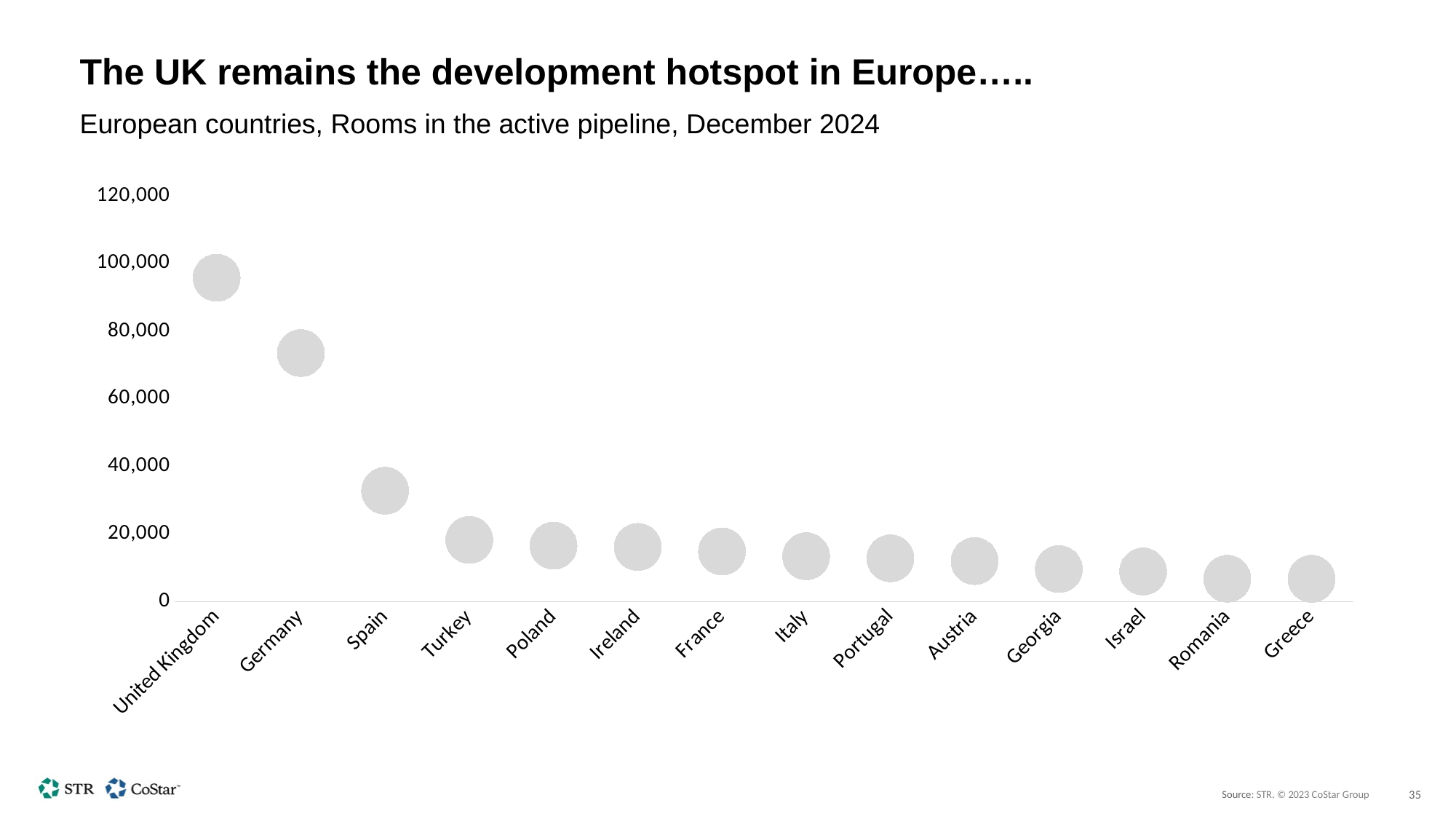
Which has more rooms in the active pipeline, Spain or Turkey? Spain What kind of chart is shown on the slide? scatter chart Which has more rooms in the active pipeline, the United Kingdom or Germany? United Kingdom Is the value for the United Kingdom greater or less than 80,000? greater Is the value for Greece greater or less than 20,000? less Is the value for Germany greater or less than 80,000? less What is the subtitle describing the chart's data? European countries, Rooms in the active pipeline, December 2024 Do the values rise or fall moving from left to right along the x axis? fall How many countries are shown on the chart? 14 Which country has the highest number of rooms in the active pipeline? United Kingdom